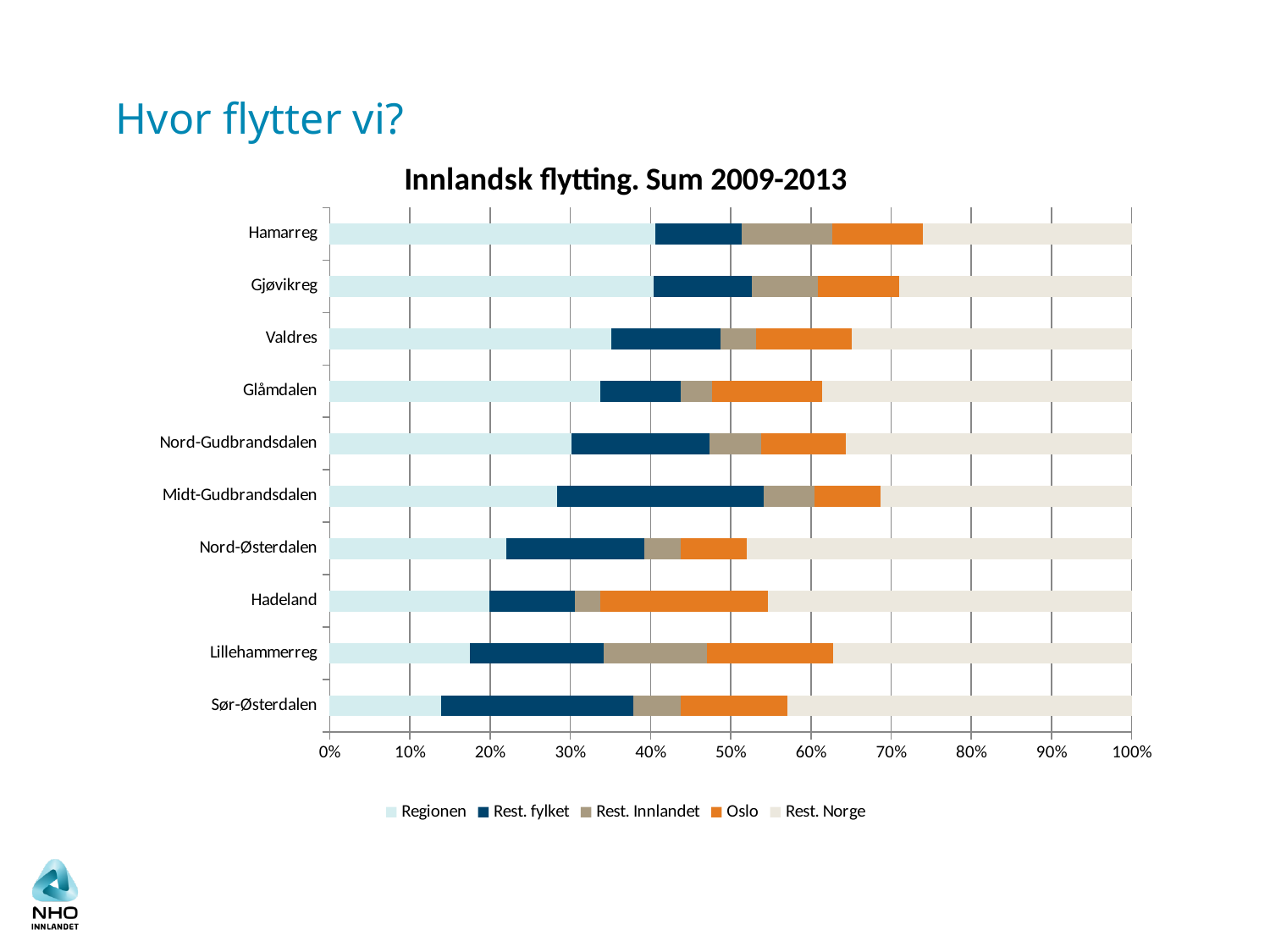
Which series is shown in orange in the chart? Oslo Which has the larger Regionen share, Valdres or Sør-Østerdalen? Valdres Is the Regionen value for Valdres greater or less than 30%? greater Which region has the smallest Regionen share? Sør-Østerdalen How many series does the legend list? 5 What kind of chart is shown on the slide? bar chart What is the title of the chart? Innlandsk flytting. Sum 2009-2013 How many regions are listed on the vertical axis of the chart? 10 Is the Regionen value for Midt-Gudbrandsdalen greater or less than 30%? less Is the Regionen value for Lillehammerreg greater or less than 20%? less Which region has the largest Oslo share? Hadeland